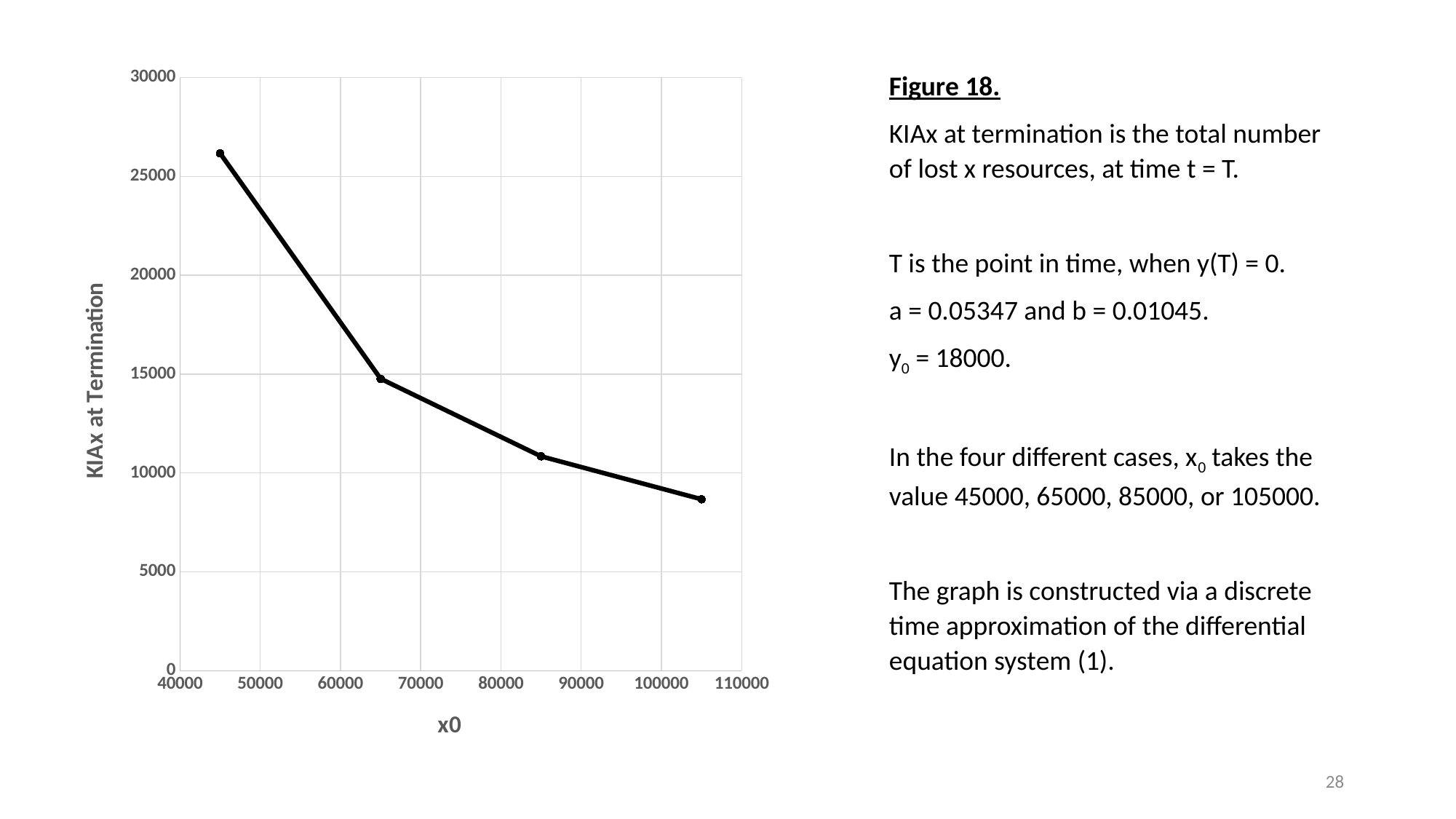
Is the value of KIAx at Termination for x0 = 105000 greater or less than 10000? less Which has a larger KIAx at Termination: x0 = 65000 or x0 = 85000? x0 = 65000 Is the value of KIAx at Termination for x0 = 45000 greater or less than 25000? greater Is the value of KIAx at Termination for x0 = 85000 greater or less than 15000? less What is the label of the horizontal axis? x0 What kind of chart is shown on the slide? line chart Do the values of KIAx at Termination rise or fall as x0 increases? fall At which value of x0 is KIAx at Termination lowest? 105000 What is the label of the vertical axis? KIAx at Termination At which value of x0 is KIAx at Termination highest? 45000 How many data points are plotted on the chart? 4